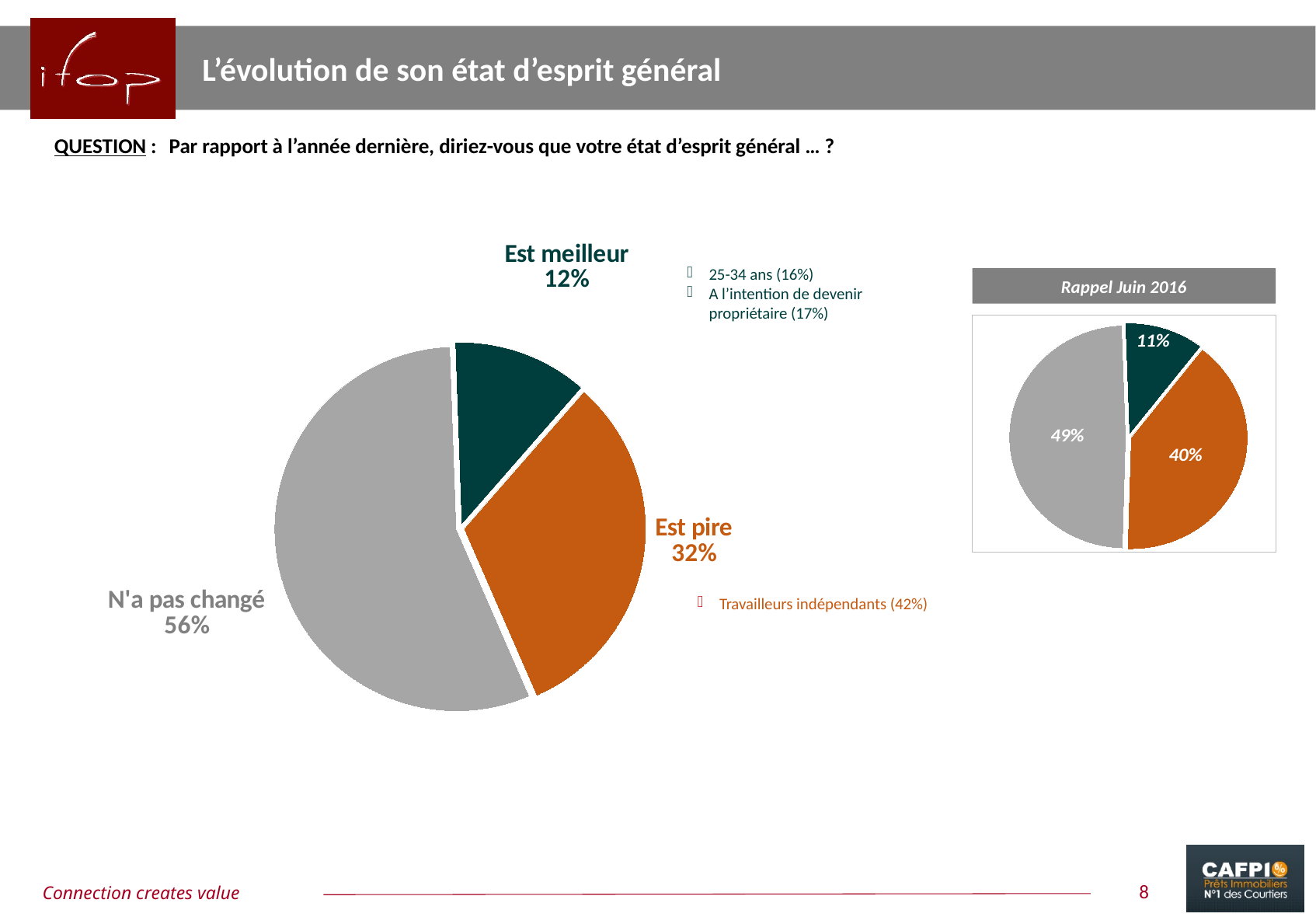
In the main pie chart, which is larger: "Est pire" or "Est meilleur"? Est pire How many slices does the main pie chart have? 3 In the main pie chart, which category has the largest share? N'a pas changé In the "Rappel Juin 2016" pie chart, what is the value of the grey slice? 49% What type of chart is used on this slide? Pie chart In the main pie chart, what is the difference in percentage points between "N'a pas changé" and "Est pire"? 24 percentage points In the main pie chart, which category has the smallest share? Est meilleur What is the title of the small pie chart on the right? Rappel Juin 2016 In the main pie chart, what share of respondents answered "Est pire"? 32% In the main pie chart, what share of respondents answered "Est meilleur"? 12% In the "Rappel Juin 2016" pie chart, what is the value of the orange slice? 40% In the main pie chart, what share of respondents answered "N'a pas changé"? 56%